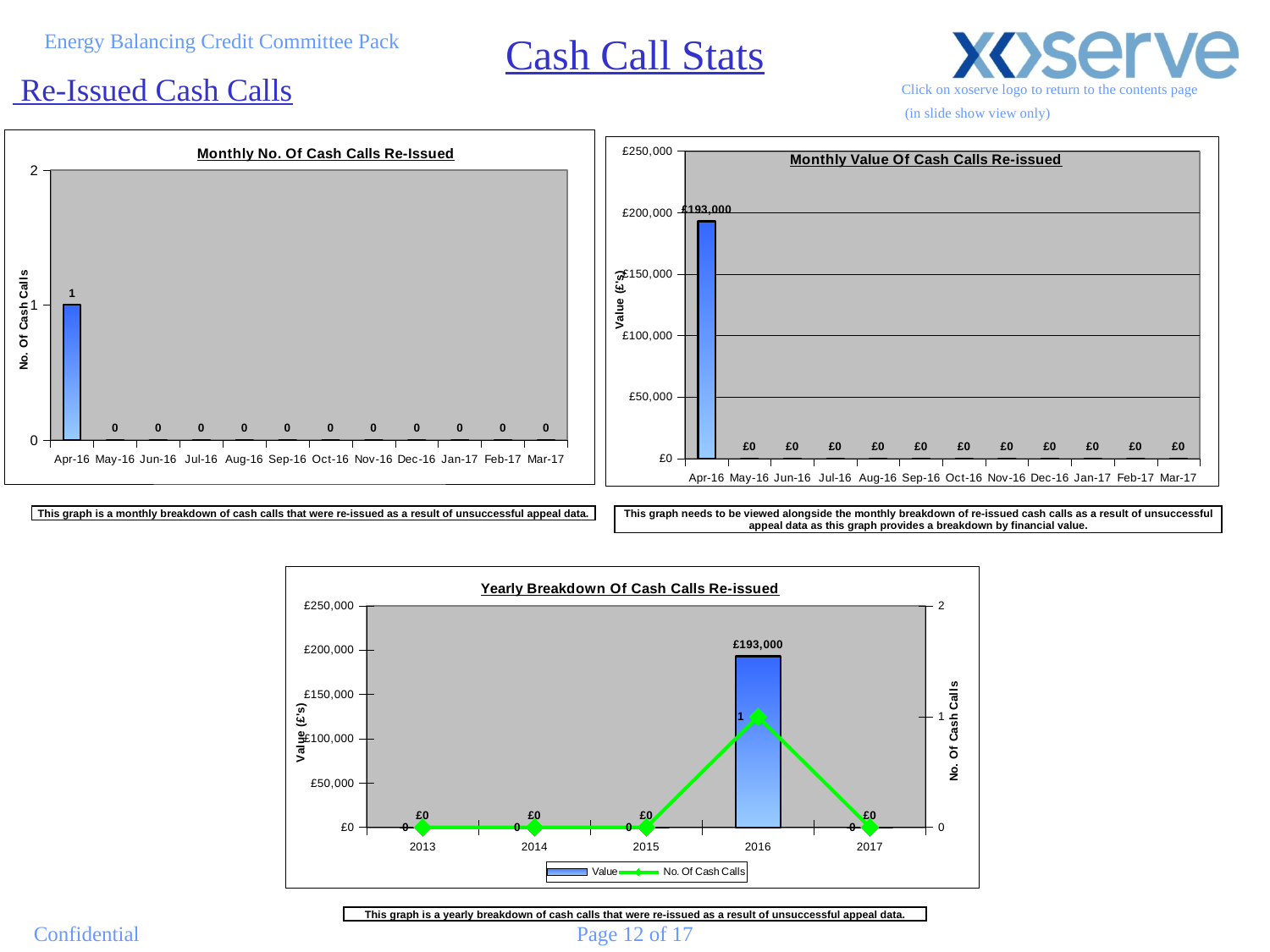
In the 'Monthly Value Of Cash Calls Re-issued' chart, what is the difference between the values for Apr-16 and May-16? £193,000 In the 'Monthly Value Of Cash Calls Re-issued' chart, what is the value for Dec-16? £0 In the 'Yearly Breakdown Of Cash Calls Re-issued' chart, which year has the highest Value? 2016 How many series does the legend of the 'Yearly Breakdown Of Cash Calls Re-issued' chart list? 2 What kind of chart is 'Monthly No. Of Cash Calls Re-Issued'? Bar chart In the 'Monthly No. Of Cash Calls Re-Issued' chart, how many months are shown on the x axis? 12 In the 'Yearly Breakdown Of Cash Calls Re-issued' chart, what is the Value for 2016? £193,000 In the 'Monthly Value Of Cash Calls Re-issued' chart, what is the value for Apr-16? £193,000 In the 'Monthly No. Of Cash Calls Re-Issued' chart, what is the value for Apr-16? 1 In the 'Monthly Value Of Cash Calls Re-issued' chart, is the value for Apr-16 greater or less than £150,000? greater In the 'Yearly Breakdown Of Cash Calls Re-issued' chart, what is the No. Of Cash Calls for 2016? 1 In the 'Monthly No. Of Cash Calls Re-Issued' chart, which month has the highest value? Apr-16